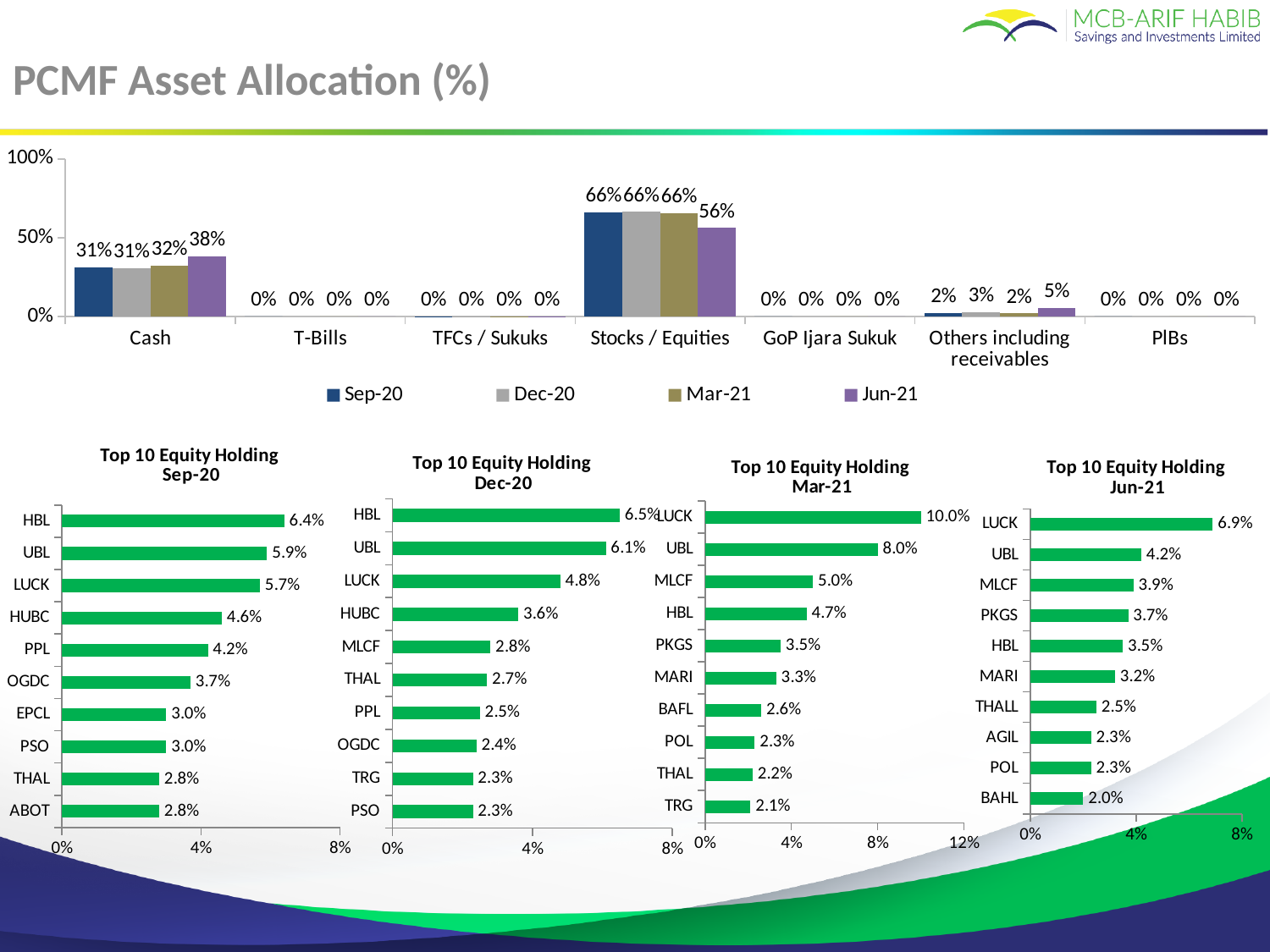
In the PCMF Asset Allocation chart, what is the difference between the Sep-20 and Jun-21 values for Stocks / Equities? 10% In the PCMF Asset Allocation chart, what is the Jun-21 value for Stocks / Equities? 56% In the Top 10 Equity Holding Mar-21 chart, what is the value for LUCK? 10.0% In the Top 10 Equity Holding Jun-21 chart, which holding has the lowest value? BAHL In the PCMF Asset Allocation chart, how many series does the legend list? 4 What kind of chart is the Top 10 Equity Holding Jun-21 chart? Bar chart In the Top 10 Equity Holding Dec-20 chart, which holding has the highest value? HBL In the PCMF Asset Allocation chart, what is the Jun-21 value for Cash? 38% In the Top 10 Equity Holding Sep-20 chart, what is the value for HUBC? 4.6% In the PCMF Asset Allocation chart, which category has the highest Mar-21 value? Stocks / Equities In the PCMF Asset Allocation chart, how many categories are shown on the x axis? 7 In the Top 10 Equity Holding Mar-21 chart, what is the difference between the values for LUCK and UBL? 2.0%